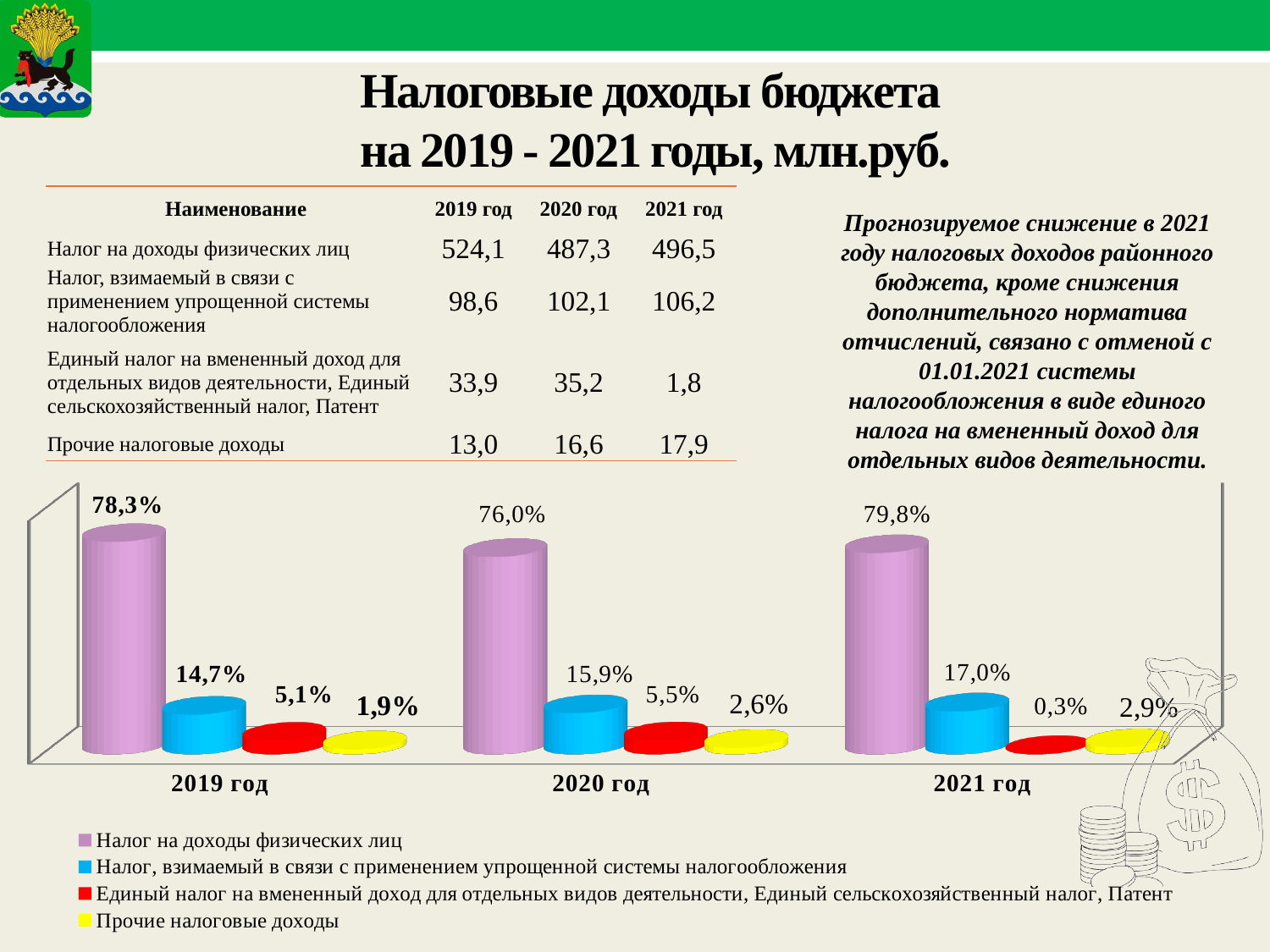
What is the value for Налог на доходы физических лиц in 2019 год? 78,3% Which is larger: the value for Прочие налоговые доходы in 2020 год or in 2019 год? 2020 год What is the value for Налог, взимаемый в связи с применением упрощенной системы налогообложения in 2020 год? 15,9% What is the difference between the values for Налог на доходы физических лиц in 2021 год and 2020 год? 3,8% What is the value for Единый налог на вмененный доход для отдельных видов деятельности, Единый сельскохозяйственный налог, Патент in 2021 год? 0,3% Does the value for Налог, взимаемый в связи с применением упрощенной системы налогообложения rise or fall from 2019 год to 2021 год? rise How many years are shown on the x axis of the chart? 3 What kind of chart is shown on the slide? bar chart How many series does the chart legend list? 4 In which year is the value for Единый налог на вмененный доход для отдельных видов деятельности, Единый сельскохозяйственный налог, Патент the lowest? 2021 год What is the value for Прочие налоговые доходы in 2021 год? 2,9%